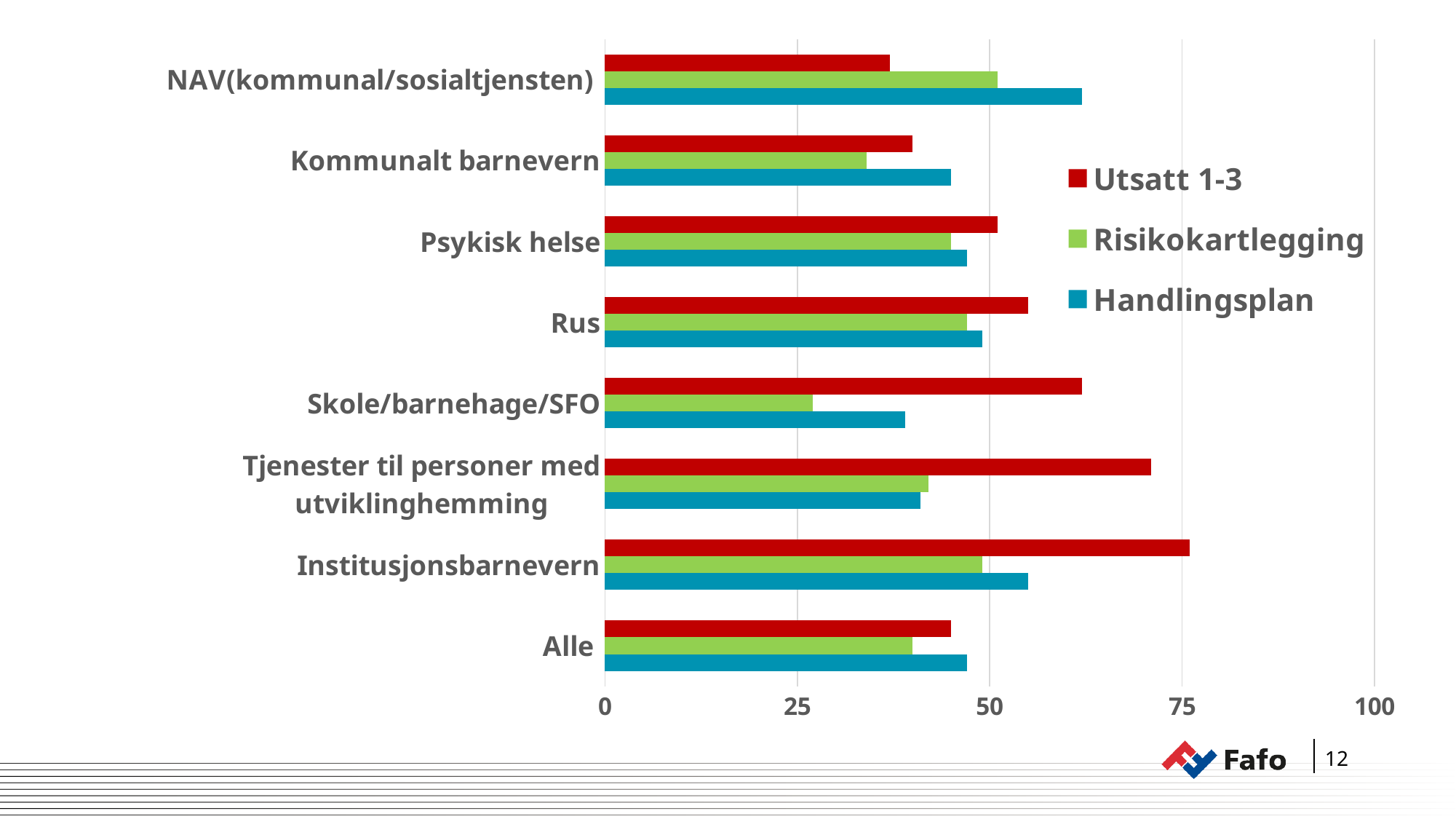
How many series does the legend list? 3 Is the Utsatt 1-3 value for NAV(kommunal/sosialtjensten) greater or less than 50? less For NAV(kommunal/sosialtjensten), which is larger: the Handlingsplan value or the Utsatt 1-3 value? Handlingsplan How many categories are shown on the vertical axis? 8 For Skole/barnehage/SFO, which is larger: the Utsatt 1-3 value or the Risikokartlegging value? Utsatt 1-3 Which category has the highest value for Handlingsplan? NAV(kommunal/sosialtjensten) Is the Risikokartlegging value for Skole/barnehage/SFO greater or less than 25? greater Which category has the highest value for Utsatt 1-3? Institusjonsbarnevern What kind of chart is shown on the slide? bar chart Which category has the lowest value for Risikokartlegging? Skole/barnehage/SFO Which colour represents the Handlingsplan series in the legend? blue